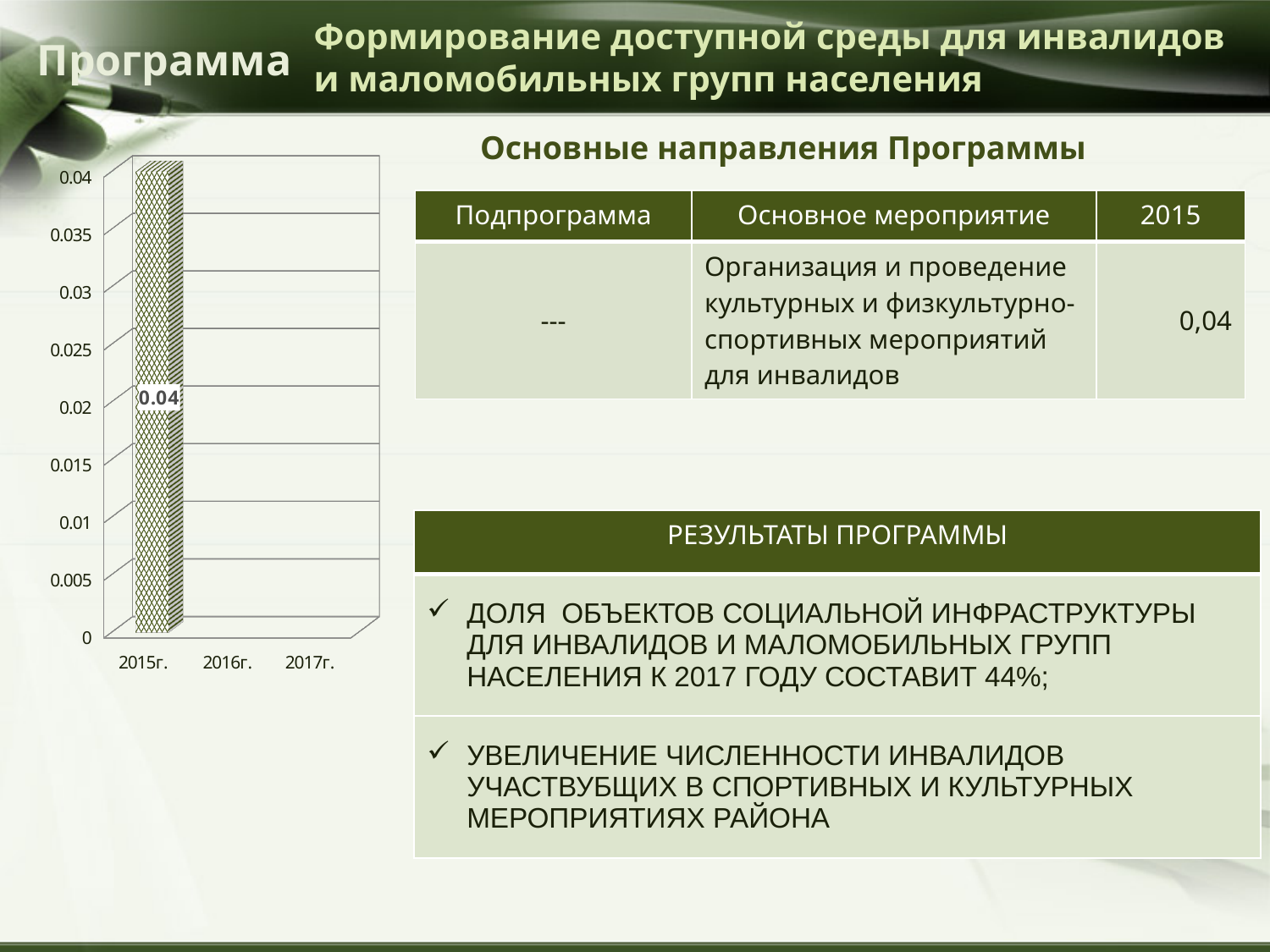
What is the last category label on the x axis of the chart? 2017г. Which category has the highest value in the chart? 2015г. What is the value shown for 2015г. in the chart? 0.04 Is the value for 2015г. greater or less than 0.02? greater Is the value for 2015г. greater or less than 0.035? greater What is the first category label on the x axis of the chart? 2015г. Which categories on the x axis have no visible bar? 2016г. and 2017г. How many categories are shown on the x axis of the chart? 3 What kind of chart is shown on the slide? bar chart What is the maximum value shown on the vertical axis of the chart? 0.04